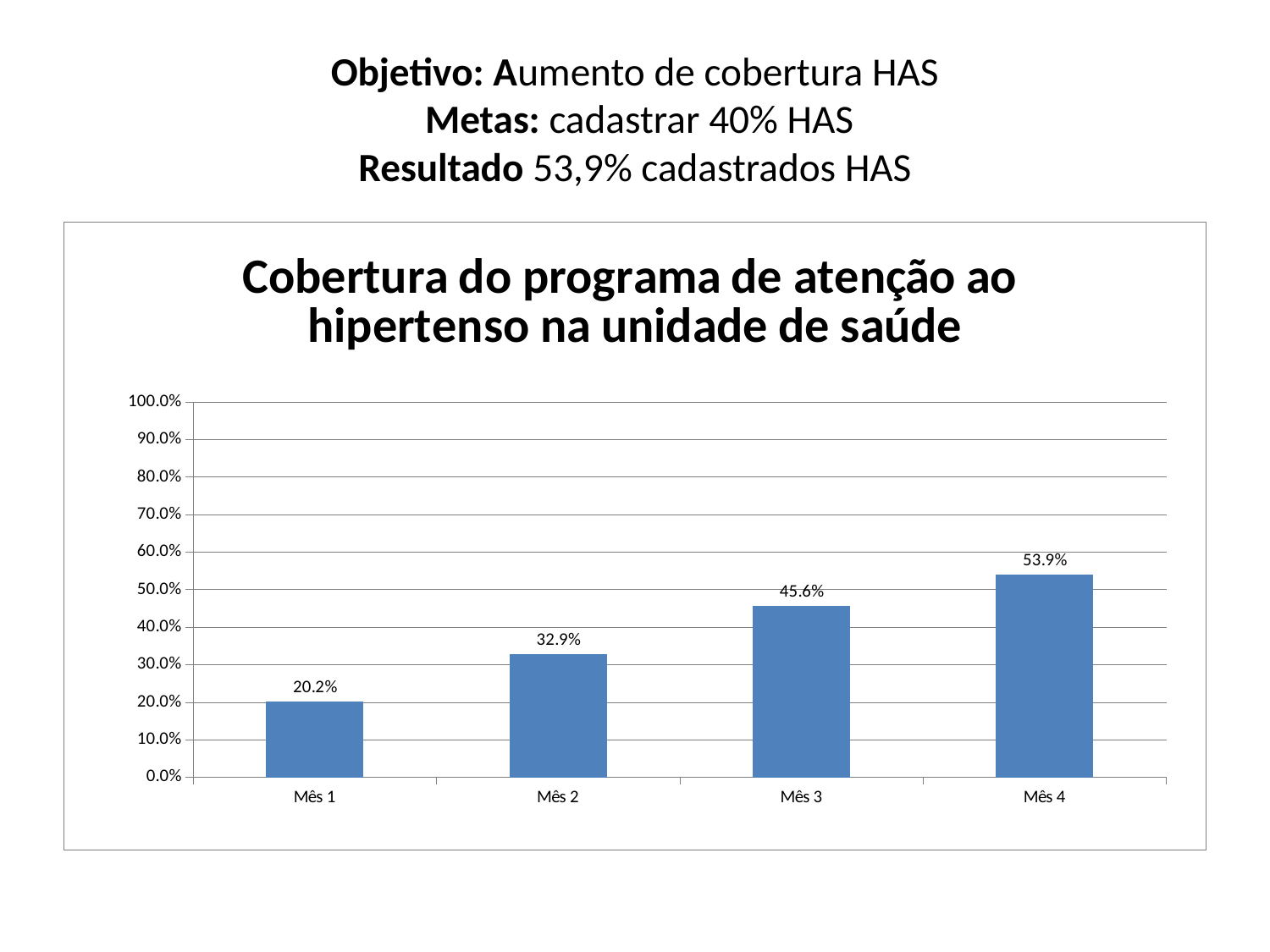
Do the values rise or fall from Mês 1 to Mês 4? rise What is the value for Mês 1? 20.2% What kind of chart is shown? bar chart Which month has the lowest value? Mês 1 Which is larger, the value for Mês 2 or the value for Mês 3? Mês 3 What is the value for Mês 4? 53.9% Which month has the highest value? Mês 4 Is the value for Mês 2 greater or less than 40.0%? less What is the value for Mês 3? 45.6% What is the difference between the values for Mês 4 and Mês 1? 33.7% How many months are shown on the x axis? 4 What is the difference between the values for Mês 3 and Mês 2? 12.7%